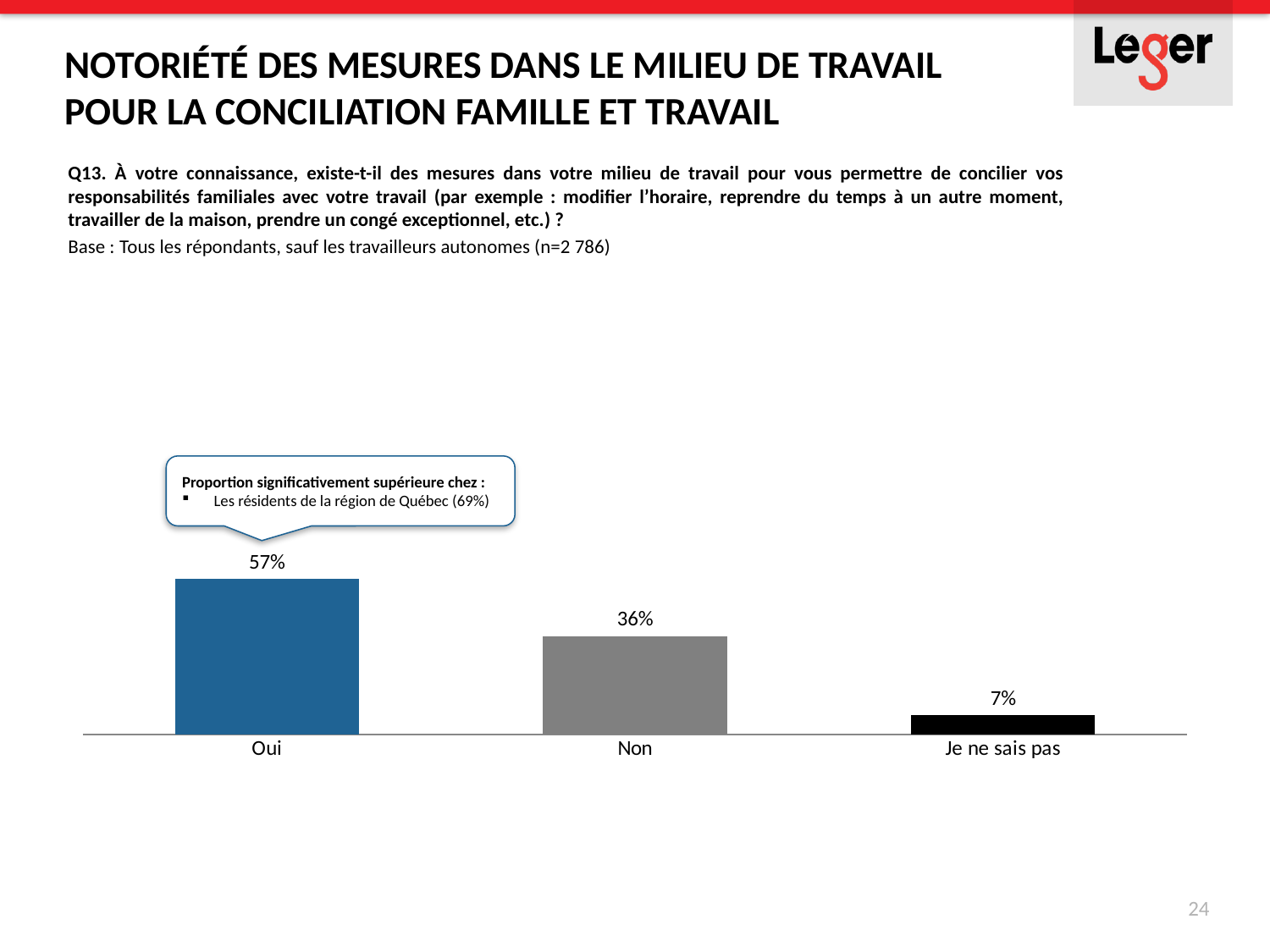
What is the value for Non? 36% How many categories are shown in the chart? 3 What is the value for Oui? 57% Which is larger, the value for Oui or the value for Non? Oui What is the value for Je ne sais pas? 7% What is the difference between the values for Non and Je ne sais pas? 29% What is the difference between the values for Oui and Non? 21% Which category has the lowest value? Je ne sais pas According to the callout above the Oui bar, what is the proportion among residents of the Québec region? 69% What kind of chart is shown on the slide? Bar chart Which category has the highest value? Oui Do the values rise or fall from left to right across the categories? Fall